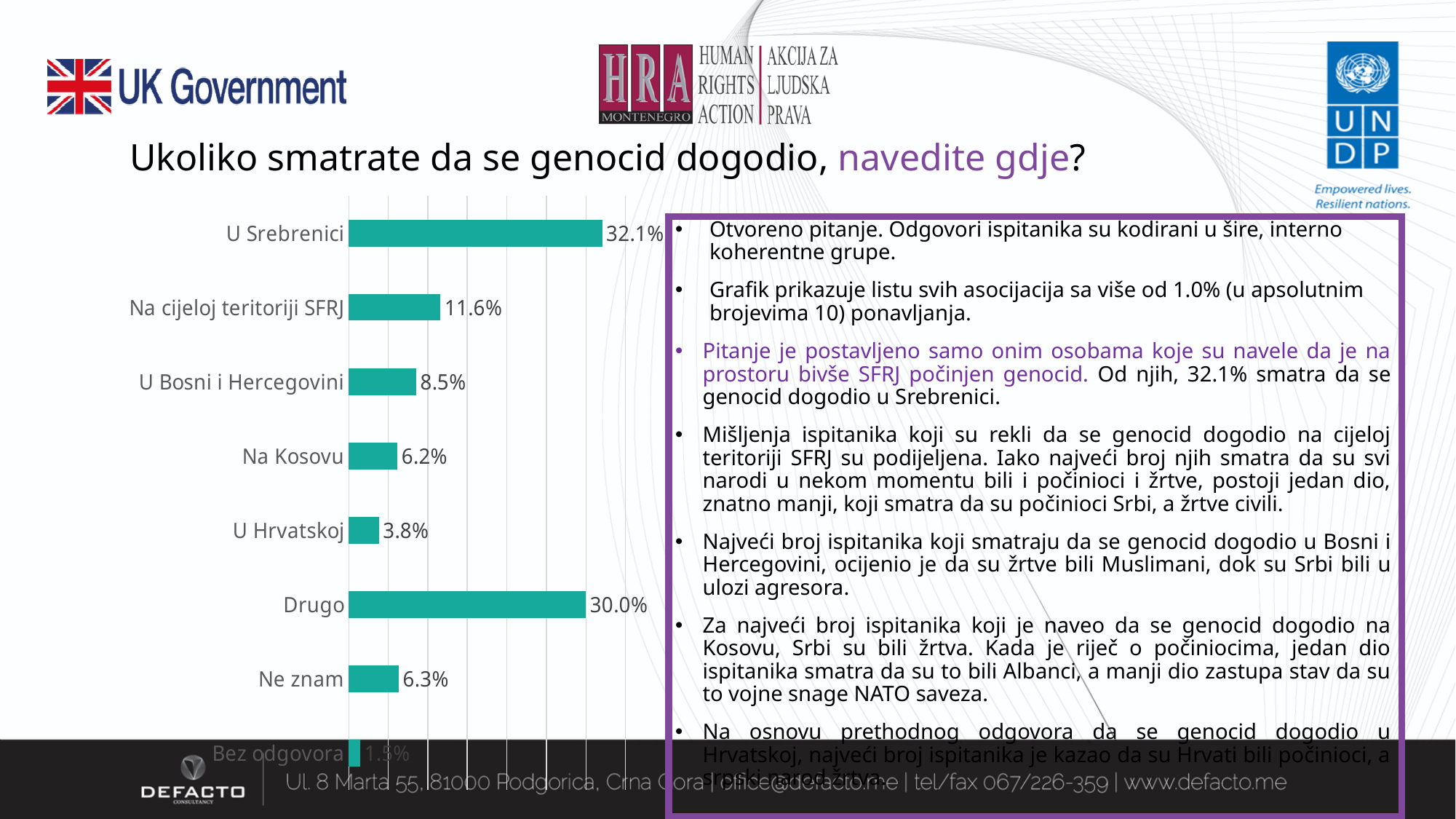
Which category has the highest value in the chart? U Srebrenici What is the difference between the values for "U Bosni i Hercegovini" and "Na Kosovu"? 2.3% Which category has the lowest value in the chart? Bez odgovora Which is larger, the value for "Na cijeloj teritoriji SFRJ" or the value for "U Bosni i Hercegovini"? Na cijeloj teritoriji SFRJ What type of chart is shown on the slide? Bar chart What percentage of respondents answered "U Srebrenici"? 32.1% What is the value shown for "Drugo"? 30.0% What is the difference between the values for "U Srebrenici" and "Drugo"? 2.1% How many categories are shown in the chart? 8 What is the value shown for "Na cijeloj teritoriji SFRJ"? 11.6% What is the value shown for "U Hrvatskoj"? 3.8% What colour are the bars in the chart? Teal